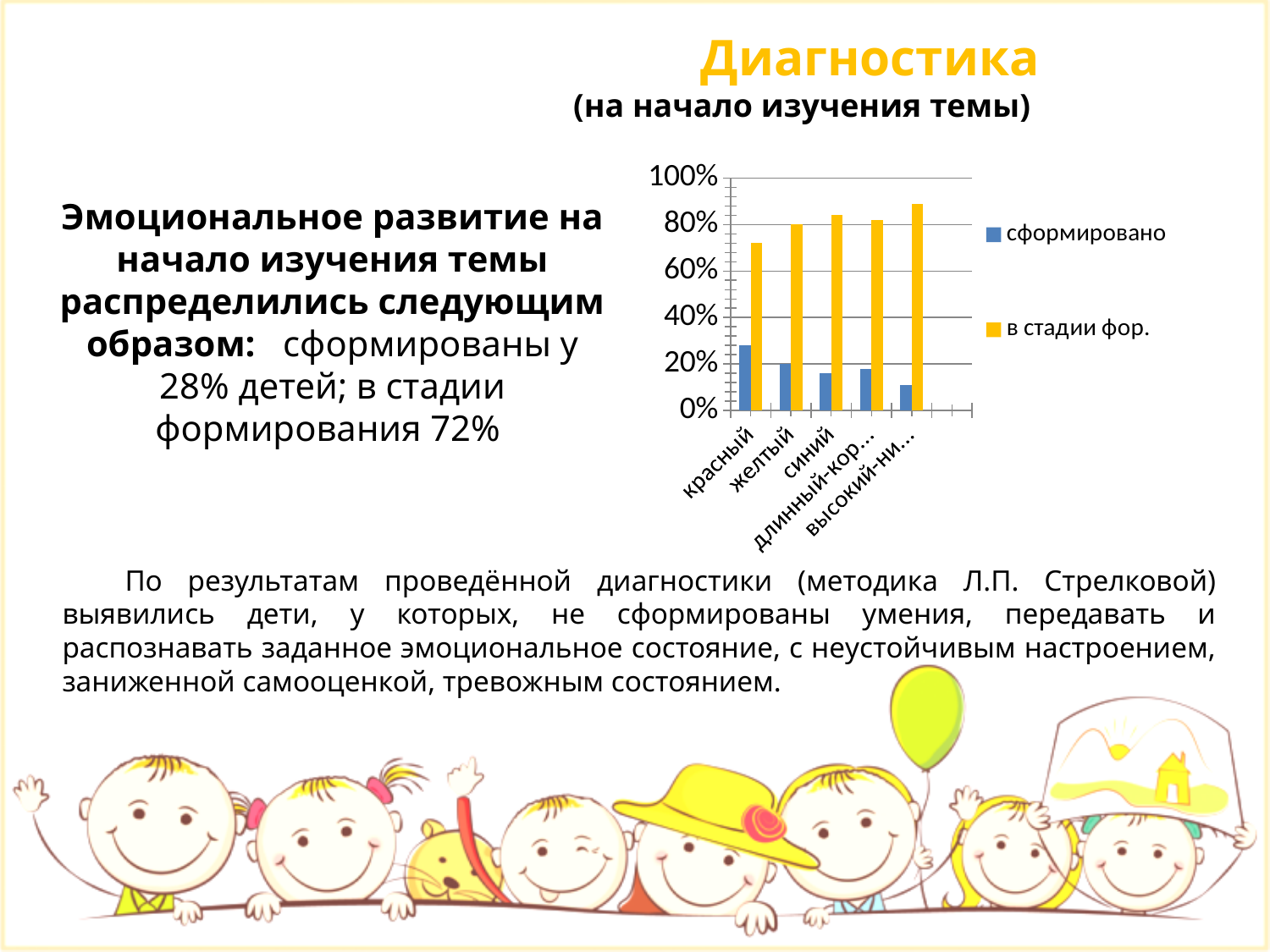
Is the value of "в стадии фор." for высокий-ни... greater or less than 80%? greater Which category has the highest value for the series "в стадии фор."? высокий-ни... What colour are the bars for the series "сформировано"? blue How many series does the chart legend list? 2 Is the value of "сформировано" for высокий-ни... greater or less than 20%? less Which category has the lowest value for the series "сформировано"? высокий-ни... How many categories are shown on the x axis of the chart? 5 Which category has the highest value for the series "сформировано"? красный Is the value of "в стадии фор." for красный greater or less than 60%? greater What kind of chart is shown on the slide? bar chart Which category has the lowest value for the series "в стадии фор."? красный For the category красный, which series has the larger value, "сформировано" or "в стадии фор."? в стадии фор.